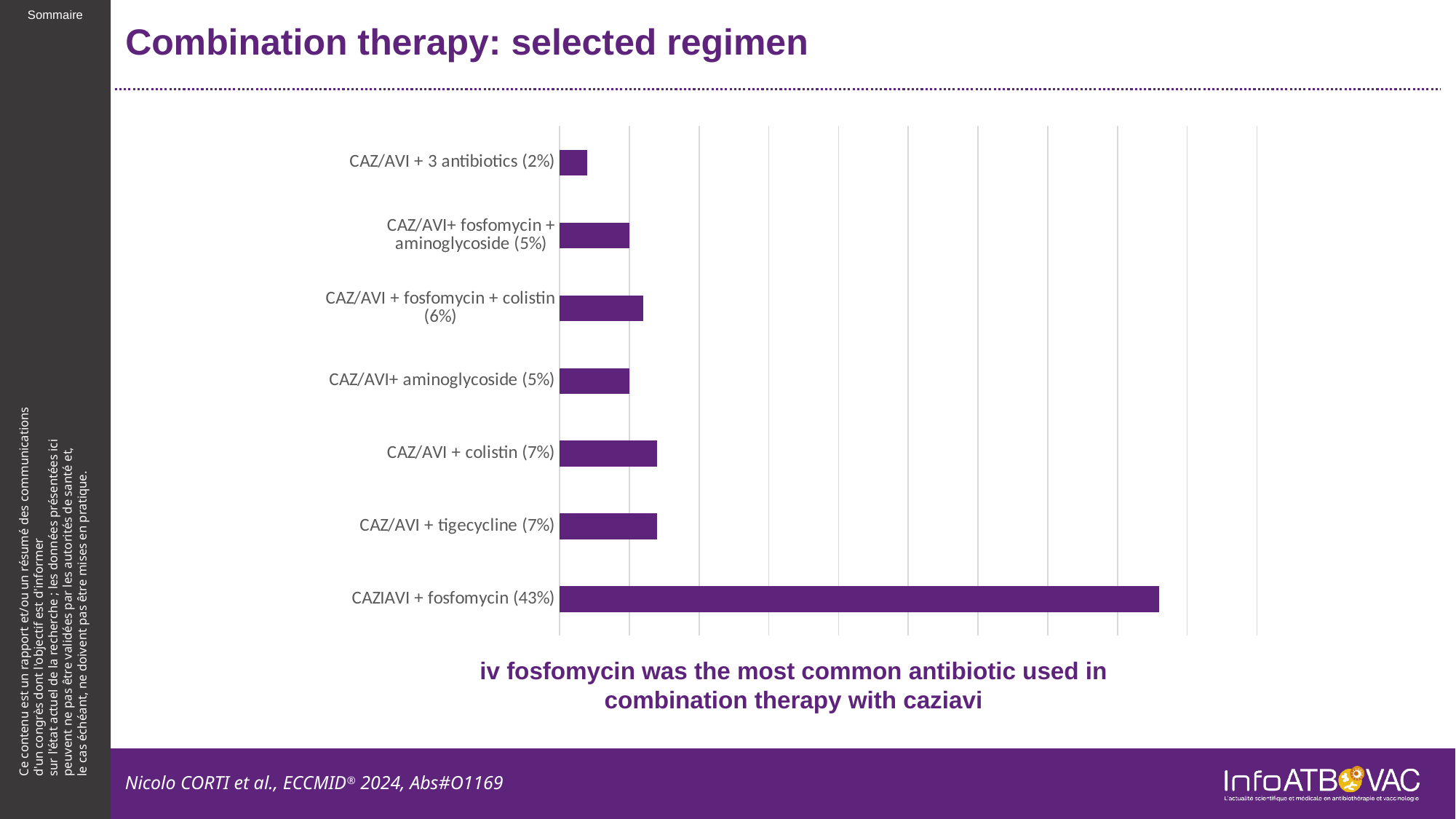
What percentage is shown for CAZ/AVI + fosfomycin + colistin? 6% What percentage is shown for CAZ/AVI + fosfomycin? 43% Which regimen has the highest percentage? CAZ/AVI + fosfomycin What is the title of the slide's chart section? Combination therapy: selected regimen What percentage is shown for CAZ/AVI + colistin? 7% What percentage is shown for CAZ/AVI + 3 antibiotics? 2% What kind of chart is shown on the slide? bar chart How many regimen categories are plotted in the chart? 7 What is the difference in percentage points between CAZ/AVI + fosfomycin and CAZ/AVI + tigecycline? 36 Which regimen has the lowest percentage? CAZ/AVI + 3 antibiotics What is the difference in percentage points between CAZ/AVI + colistin and CAZ/AVI + 3 antibiotics? 5 Which has a larger percentage, CAZ/AVI + fosfomycin + colistin or CAZ/AVI + aminoglycoside? CAZ/AVI + fosfomycin + colistin